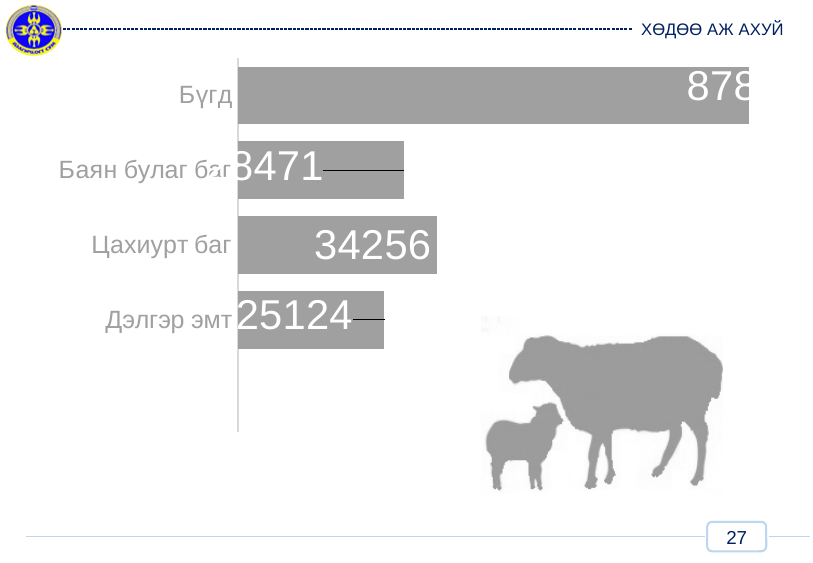
Which is larger, the value for Бүгд or the value for Цахиурт баг? Бүгд Which category has the longest bar? Бүгд Which category is listed at the top of the bar chart? Бүгд Which is larger, the value for Баян булаг баг or the value for Цахиурт баг? Цахиурт баг How many categories does the bar chart show? 4 What is the value for Цахиурт баг? 34256 What colour are the bars in the chart? grey Which is larger, the value for Цахиурт баг or the value for Дэлгэр эмт? Цахиурт баг What kind of chart is shown on the slide? bar chart Which category has the shortest bar? Дэлгэр эмт What is the value for Дэлгэр эмт? 25124 What is the difference between the values for Цахиурт баг and Дэлгэр эмт? 9132